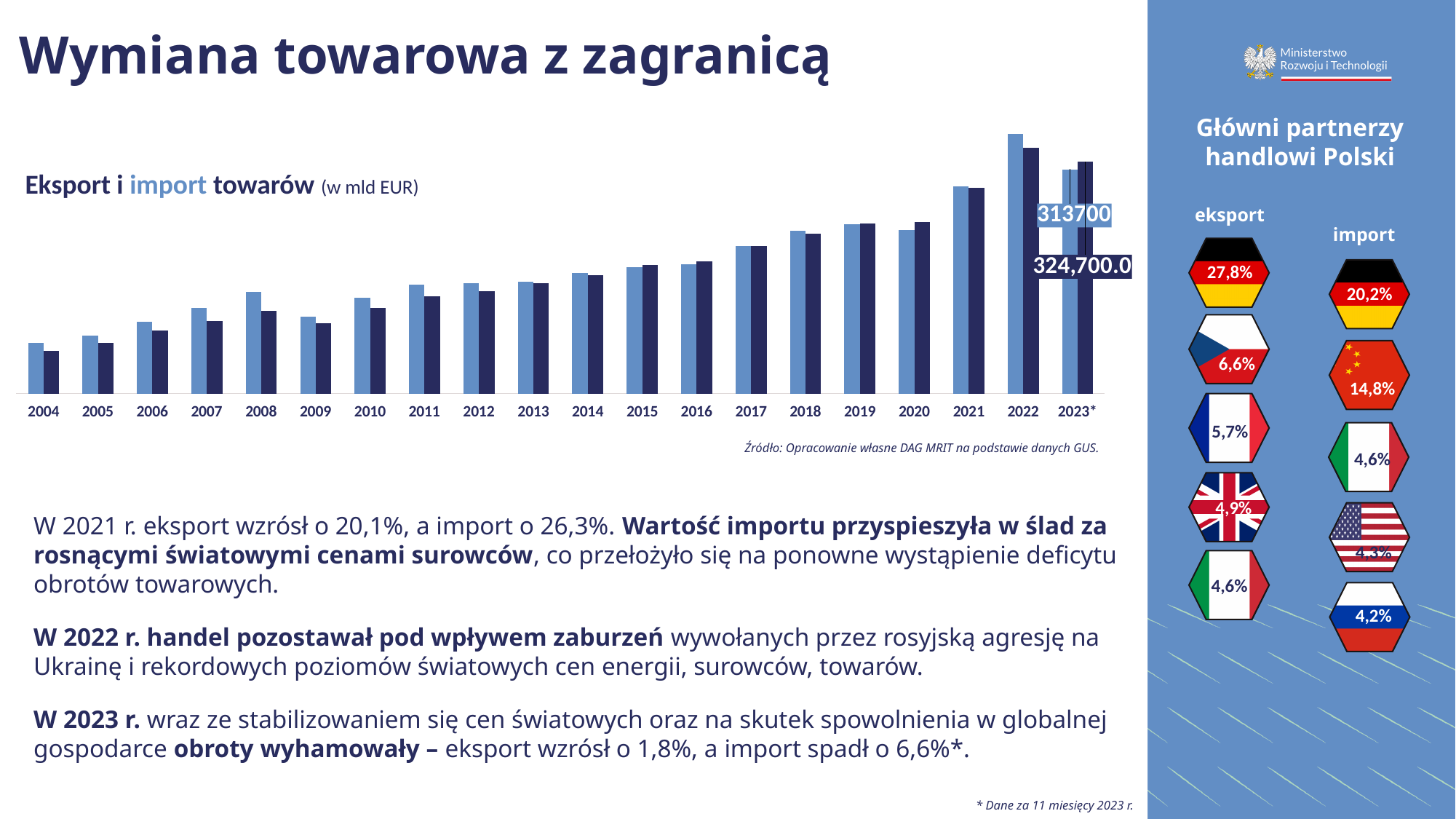
Which colour represents import in the 'Eksport i import towarów' chart? light blue In 2023*, which is larger in the 'Eksport i import towarów' chart: eksport or import? eksport In what unit are the values of the 'Eksport i import towarów' chart expressed? mld EUR What value is labelled on the eksport bar for 2023* in the 'Eksport i import towarów' chart? 324,700.0 Do the eksport values generally rise or fall from 2004 to 2022 in the 'Eksport i import towarów' chart? rise In which year is the eksport bar the lowest in the 'Eksport i import towarów' chart? 2004 How many data series does the 'Eksport i import towarów' chart plot? 2 What value is labelled on the import bar for 2023* in the 'Eksport i import towarów' chart? 313700 What kind of chart is used to show 'Eksport i import towarów'? bar chart In which year is the eksport bar the tallest in the 'Eksport i import towarów' chart? 2022 How many years are shown on the x axis of the 'Eksport i import towarów' chart? 20 In 2022, which is larger in the 'Eksport i import towarów' chart: eksport or import? import